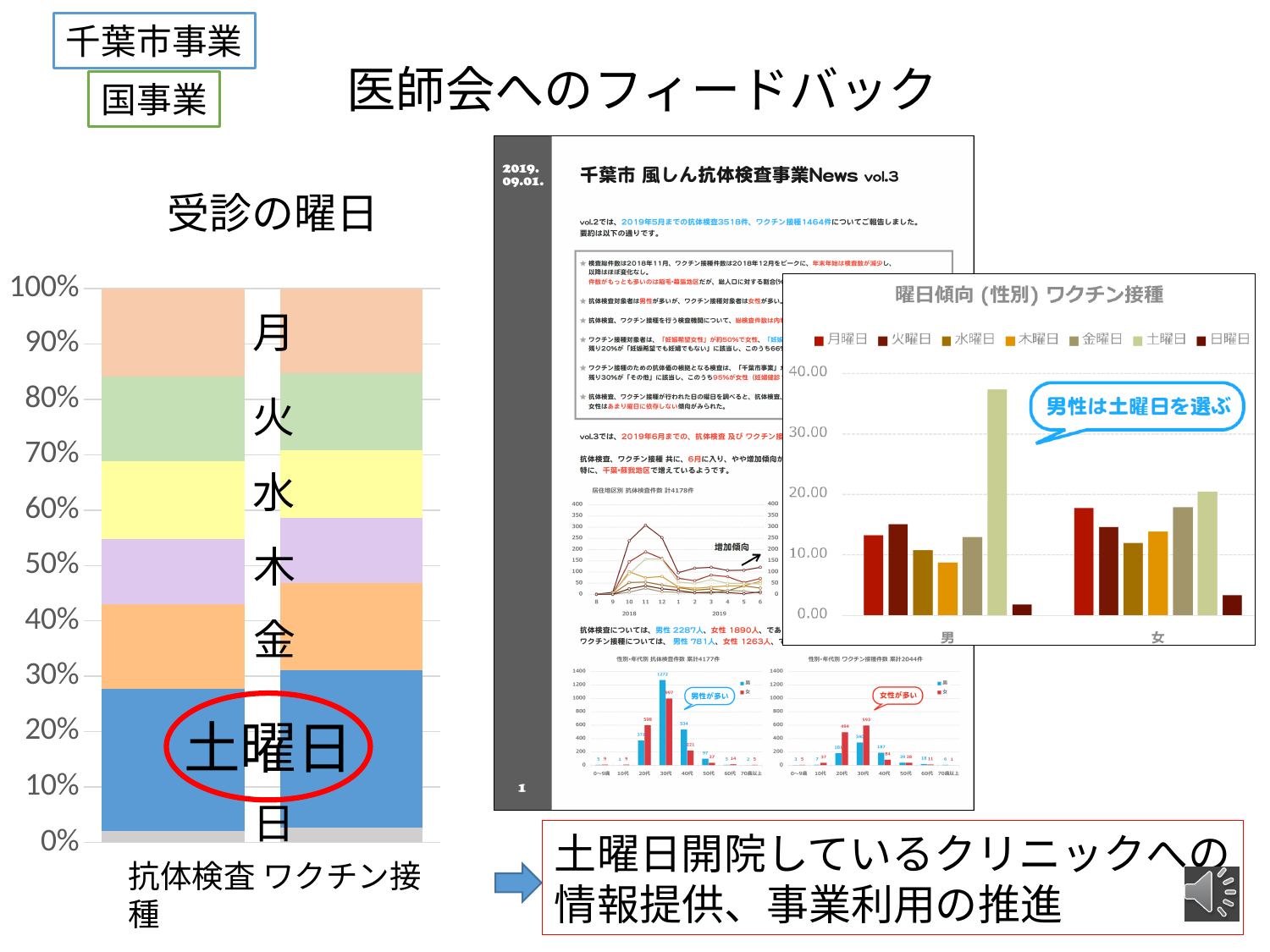
In the 曜日傾向（性別）ワクチン接種 chart, is the value for 土曜日 in the 男 group greater or less than 30.00? greater What is the title of the chart embedded in the newsletter on the right of the slide? 曜日傾向（性別）ワクチン接種 How many categories are shown on the x axis of the 受診の曜日 chart? 2 In the 受診の曜日 chart, which day of the week takes the largest share of the 抗体検査 bar? 土曜日 In the 受診の曜日 chart, which day of the week takes the smallest share of the ワクチン接種 bar? 日 In the 曜日傾向（性別）ワクチン接種 chart, which day has the highest value for 男? 土曜日 What does the callout on the 曜日傾向（性別）ワクチン接種 chart say? 男性は土曜日を選ぶ In the 曜日傾向（性別）ワクチン接種 chart, which is larger: the 月曜日 value for 男 or the 月曜日 value for 女? 女 In the 受診の曜日 chart, does the top of the 土曜日 segment in the ワクチン接種 bar lie above or below the 30% line? above In the 曜日傾向（性別）ワクチン接種 chart, which day has the lowest value for 女? 日曜日 How many series does the legend of the 曜日傾向（性別）ワクチン接種 chart list? 7 What kind of chart is the 受診の曜日 chart on the left of the slide? stacked bar chart